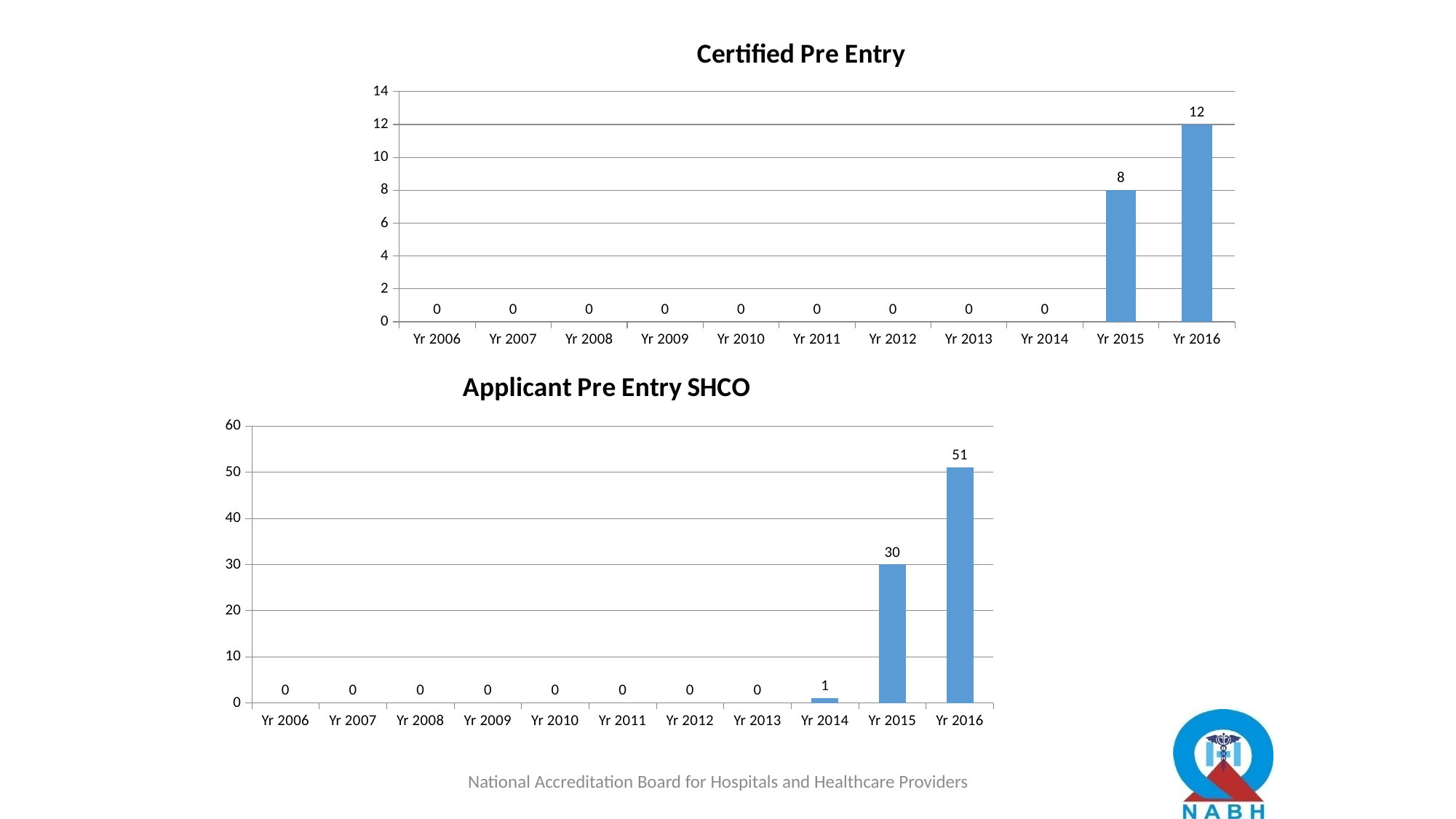
In the 'Certified Pre Entry' chart, how many years are shown on the x axis? 11 In the 'Applicant Pre Entry SHCO' chart, what is the value for Yr 2014? 1 In the 'Applicant Pre Entry SHCO' chart, what is the difference between the values for Yr 2016 and Yr 2015? 21 What kind of chart is the 'Applicant Pre Entry SHCO' chart? Bar chart In the 'Applicant Pre Entry SHCO' chart, do the values rise or fall from Yr 2014 to Yr 2016? Rise In the 'Certified Pre Entry' chart, what is the value for Yr 2015? 8 In the 'Applicant Pre Entry SHCO' chart, what is the value for Yr 2016? 51 In the 'Certified Pre Entry' chart, what is the value for Yr 2016? 12 In the 'Certified Pre Entry' chart, which year has the highest value? Yr 2016 In the 'Applicant Pre Entry SHCO' chart, what is the value for Yr 2015? 30 In the 'Certified Pre Entry' chart, what is the difference between the values for Yr 2016 and Yr 2015? 4 In the 'Applicant Pre Entry SHCO' chart, which is larger, the value for Yr 2014 or the value for Yr 2015? Yr 2015